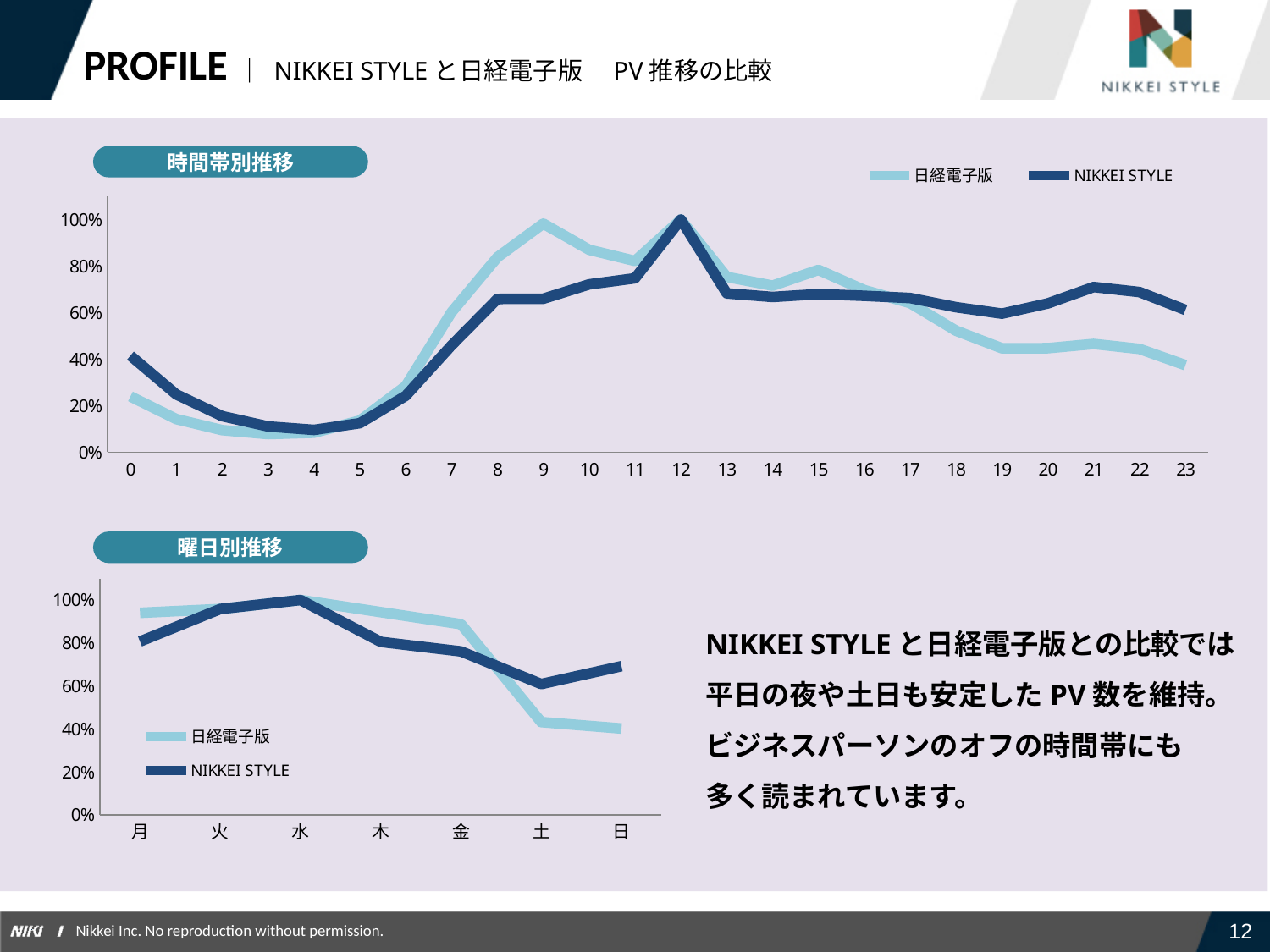
How many hour categories are shown on the x axis of the 時間帯別推移 chart? 24 What kind of chart is the 時間帯別推移 chart at the top of the slide? line chart In the 曜日別推移 chart, on which day does the NIKKEI STYLE line reach its highest value? 水 In the 時間帯別推移 chart, what is the value of NIKKEI STYLE at hour 12? 100% In the 時間帯別推移 chart, at which hour does the NIKKEI STYLE line reach its highest value? 12 In the 時間帯別推移 chart, is the value for NIKKEI STYLE at hour 21 greater or less than 60%? greater How many series does the legend of the 時間帯別推移 chart list? 2 In the 時間帯別推移 chart, which series has the larger value at hour 19, 日経電子版 or NIKKEI STYLE? NIKKEI STYLE In the 時間帯別推移 chart, is the value for 日経電子版 at hour 3 greater or less than 20%? less How many day-of-week categories are on the x axis of the 曜日別推移 chart? 7 In the 曜日別推移 chart, does the 日経電子版 line rise or fall from 水 to 日? fall In the 曜日別推移 chart, on which day is the NIKKEI STYLE value lowest? 土